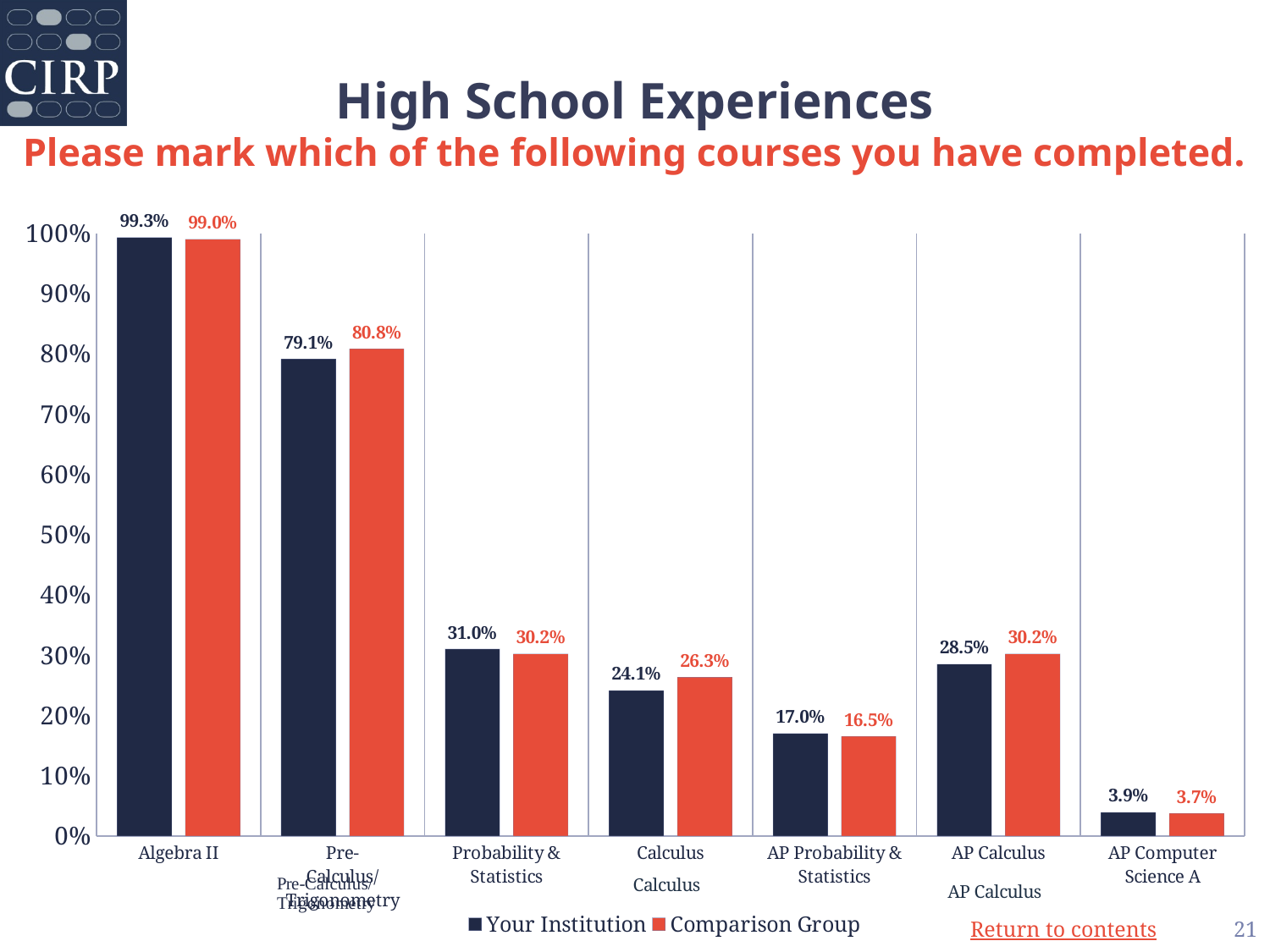
Which course has the highest value for Your Institution? Algebra II How many series does the legend list? 2 What kind of chart is shown on the slide? Bar chart Which is larger for Probability & Statistics: Your Institution or Comparison Group? Your Institution Which course has the lowest value for Comparison Group? AP Computer Science A What is the value for Your Institution for AP Calculus? 28.5% What is the value for Comparison Group for Pre-Calculus/Trigonometry? 80.8% What is the value for Comparison Group for AP Computer Science A? 3.7% What is the value for Your Institution for Algebra II? 99.3% What is the difference between Your Institution and Comparison Group for AP Probability & Statistics? 0.5% How many courses are shown on the x axis? 7 What is the difference between Your Institution and Comparison Group for Calculus? 2.2%